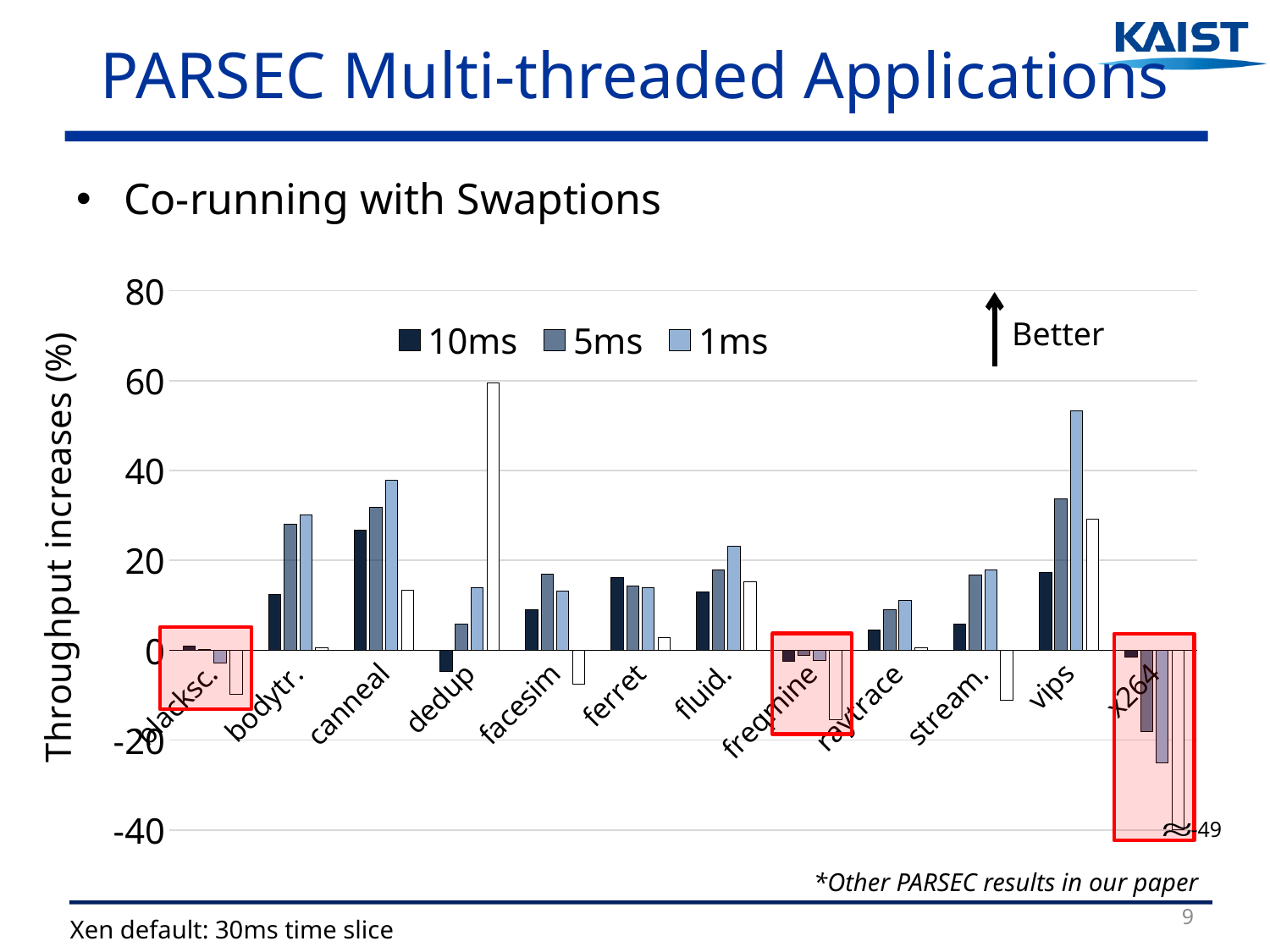
Which series are listed in the legend? 10ms, 5ms, 1ms How many application categories are shown along the x axis? 12 Which category has the highest 10ms bar? canneal Which category has the lowest 5ms bar? x264 Which is larger, the 10ms value for canneal or the 10ms value for bodytr.? canneal Is the 1ms value for canneal greater or less than 20? greater What kind of chart is shown on the slide? bar chart Which category has the highest 1ms bar? vips How many series does the chart legend list? 3 What is the title of the y axis? Throughput increases (%) What value is printed next to the x264 bar that extends below the bottom of the axis? -49 Is the 10ms value for dedup greater or less than 0? less